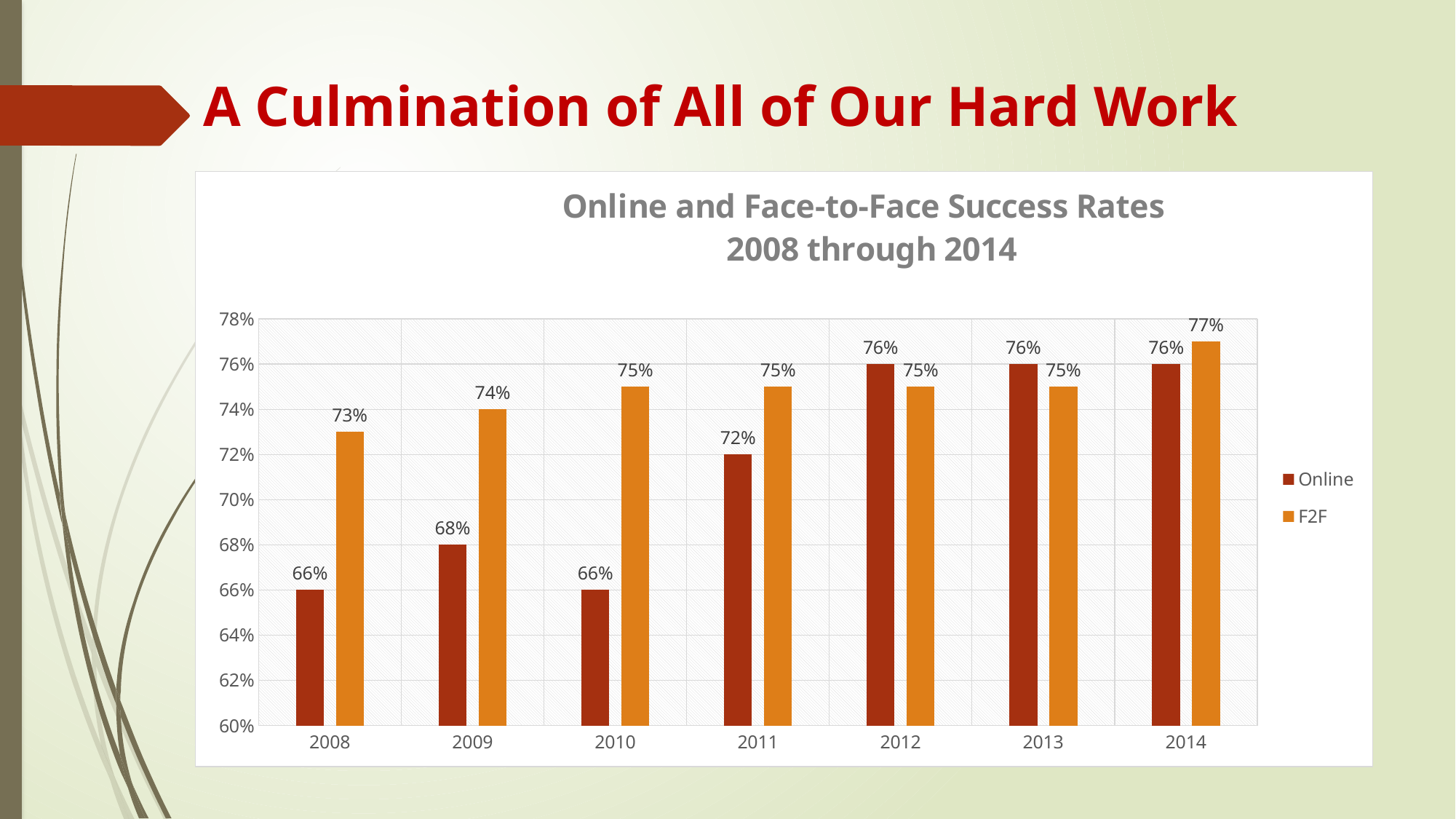
In which year is the F2F success rate highest? 2014 What is the Online success rate for 2011? 72% What is the F2F success rate for 2014? 77% Does the Online success rate generally rise or fall from 2008 to 2014? Rise Which is larger in 2012, the Online or the F2F success rate? Online How many years are shown on the x axis? 7 How many series does the legend list? 2 What is the Online success rate for 2008? 66% What is the title of the chart? Online and Face-to-Face Success Rates 2008 through 2014 What kind of chart is shown on the slide? Bar chart In which year is the Online success rate lowest? 2008 and 2010 What is the difference between the F2F and Online success rates in 2008? 7%